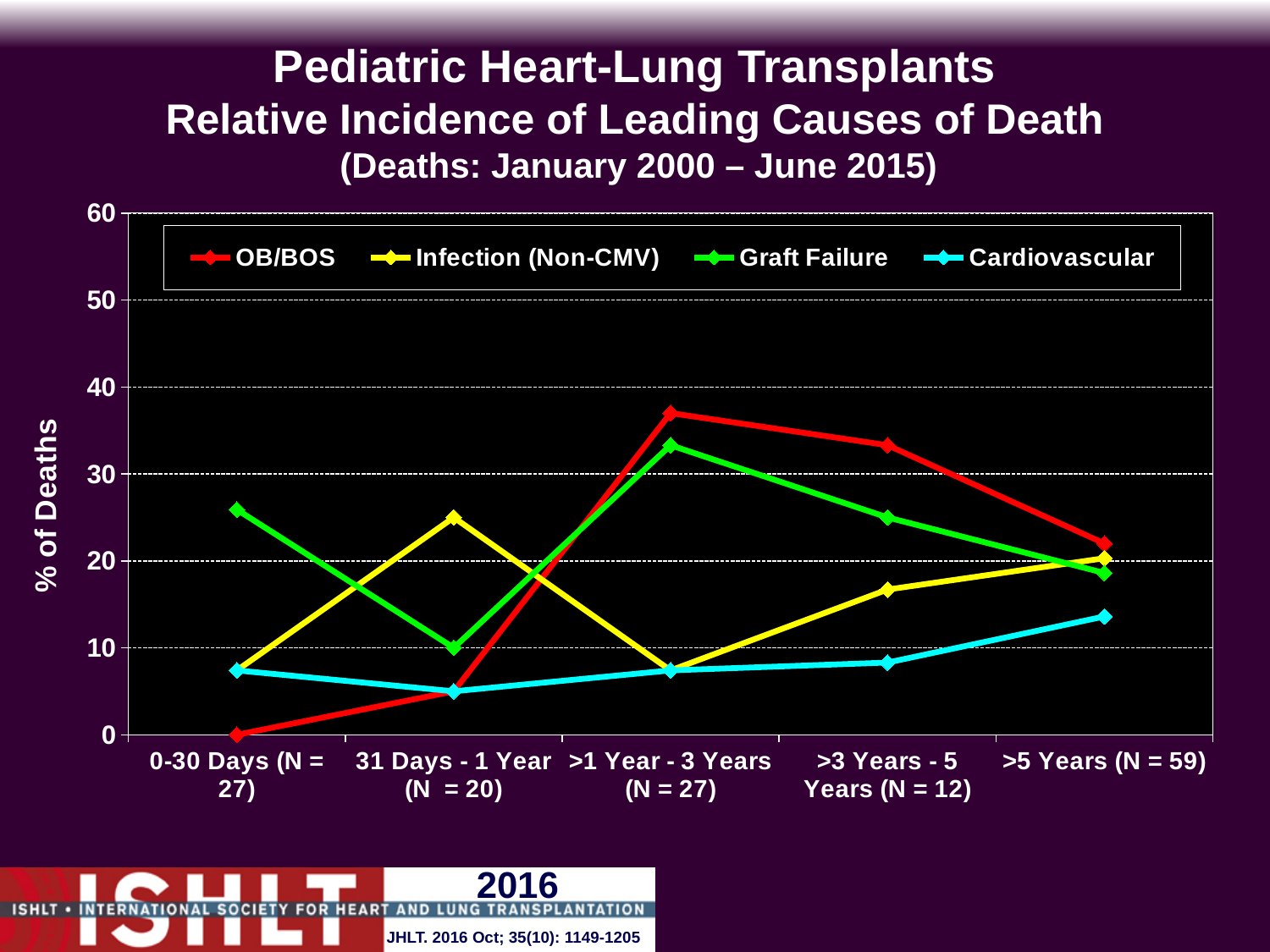
In the 31 Days - 1 Year (N = 20) category, which is larger: Infection (Non-CMV) or Graft Failure? Infection (Non-CMV) How many time-period categories are shown on the x axis? 5 Which cause of death has the highest value in the >1 Year - 3 Years (N = 27) category? OB/BOS Is the value for Graft Failure in the 0-30 Days (N = 27) category greater or less than 20? greater What is the label on the y axis? % of Deaths Does the Cardiovascular line rise or fall from >1 Year - 3 Years to >5 Years? Rises What is the value for OB/BOS in the 0-30 Days (N = 27) category? 0 Is the value for OB/BOS in the >1 Year - 3 Years (N = 27) category greater or less than 30? greater Which cause of death has the lowest value in the 0-30 Days (N = 27) category? OB/BOS How many series does the legend list? 4 What kind of chart is shown on the slide? Line chart Is the value for Cardiovascular in the >5 Years (N = 59) category greater or less than 10? greater